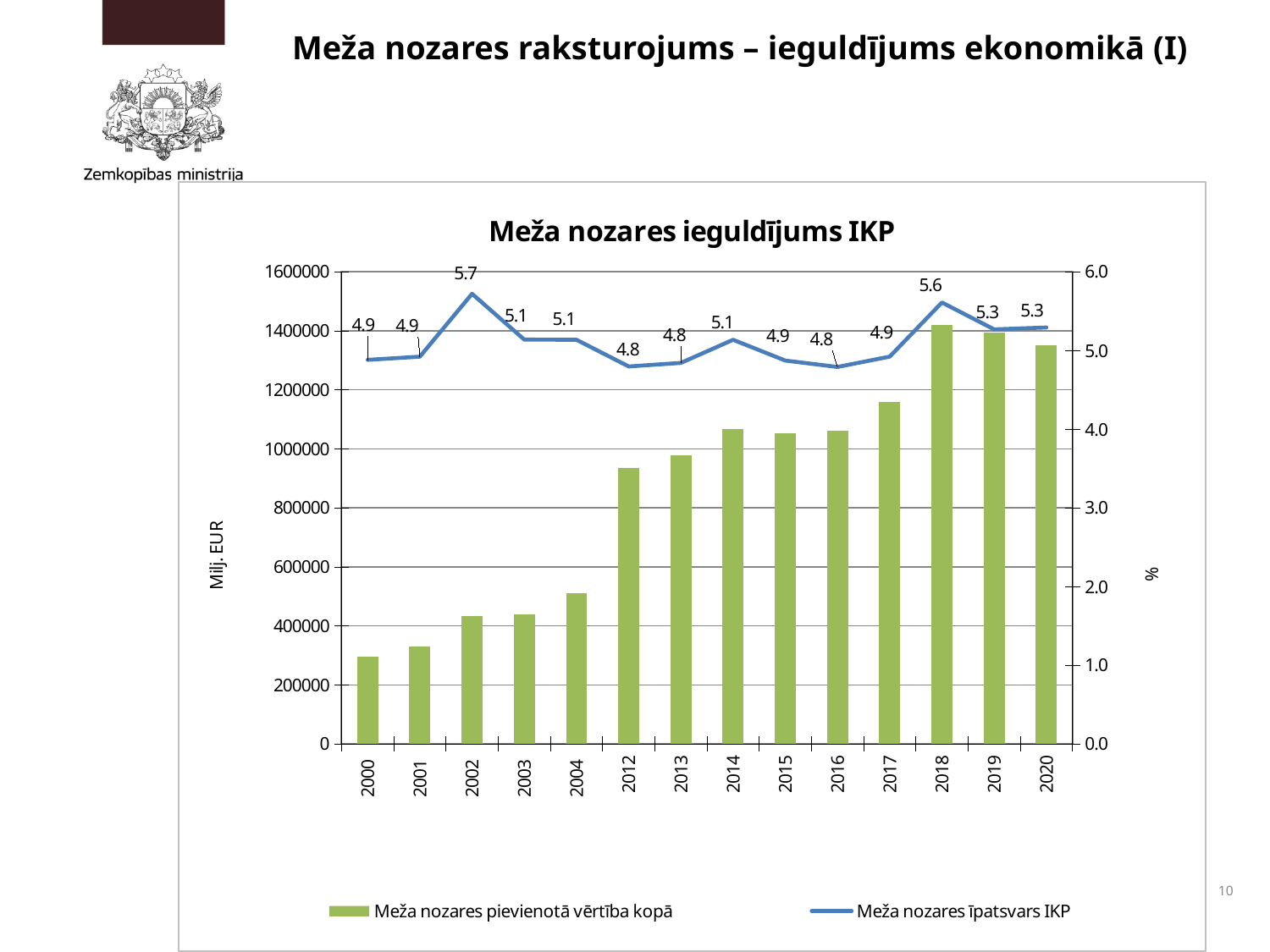
What is the value of Meža nozares īpatsvars IKP for 2020? 5.3 What is the difference between Meža nozares īpatsvars IKP in 2002 and in 2000? 0.8 How many years are shown on the x axis of the chart? 14 In which year is Meža nozares īpatsvars IKP highest? 2002 Is the bar value for Meža nozares pievienotā vērtība kopā in 2012 greater or less than 1000000? less In which year is the bar for Meža nozares pievienotā vērtība kopā highest? 2018 In which year is the bar for Meža nozares pievienotā vērtība kopā lowest? 2000 How many series does the chart legend list? 2 Which year has a higher Meža nozares īpatsvars IKP, 2018 or 2019? 2018 What is the value of Meža nozares īpatsvars IKP for 2018? 5.6 What is the value of Meža nozares īpatsvars IKP for 2002? 5.7